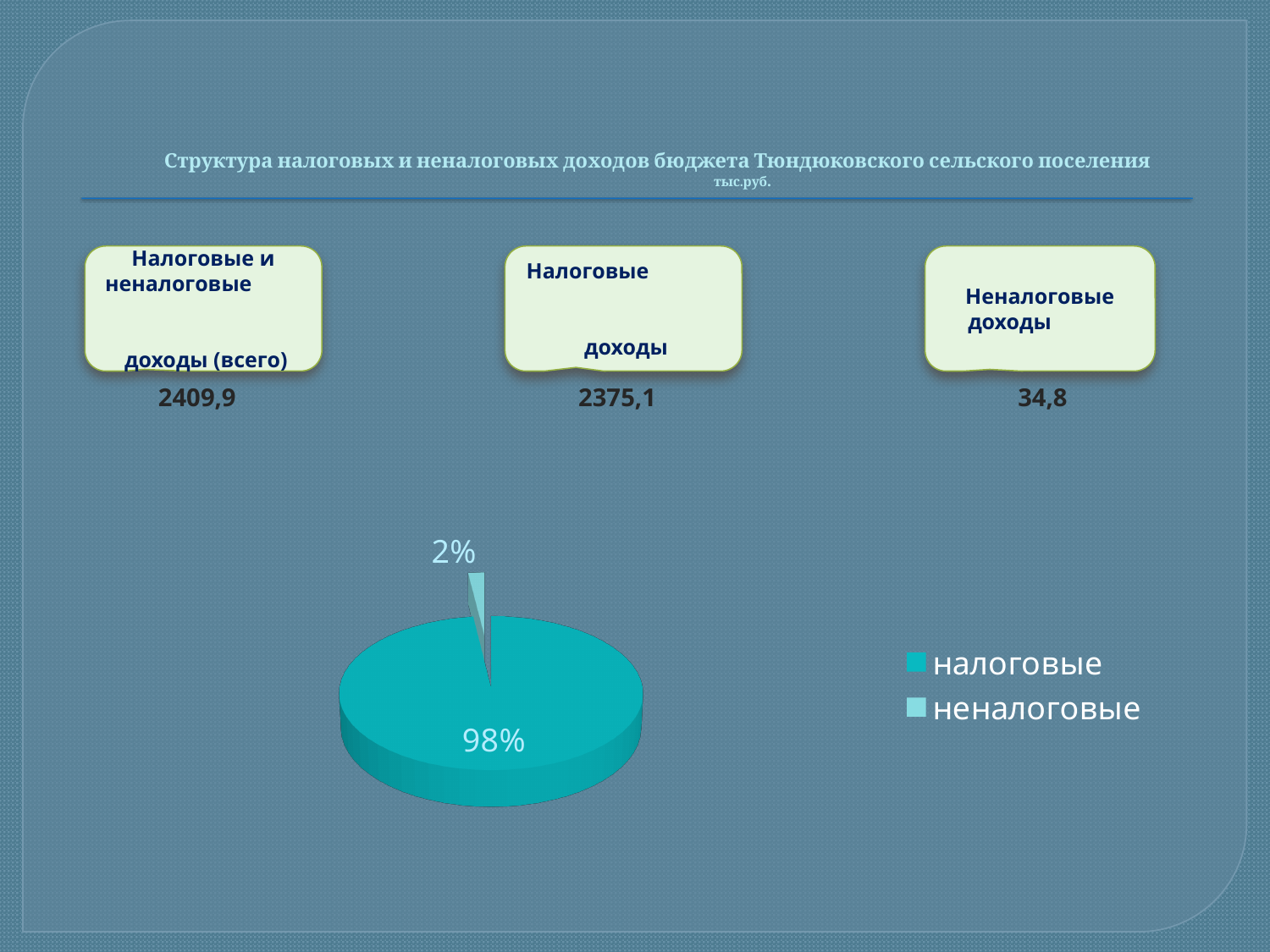
How many slices does the pie chart have? 2 What share of the pie does the неналоговые slice represent? 2% Which slice of the pie chart is the largest? налоговые What kind of chart is shown on the slide? pie chart Which slice of the pie chart is pulled out (exploded) from the rest? неналоговые Which is larger in the pie chart, налоговые or неналоговые? налоговые What is the difference in percentage points between the налоговые and неналоговые slices? 96 Which legend entry is shown in the lighter teal colour? неналоговые Which slice of the pie chart is the smallest? неналоговые What share of the pie does the налоговые slice represent? 98% How many entries does the legend of the pie chart list? 2 What is the total of the two percentages shown on the pie chart? 100%